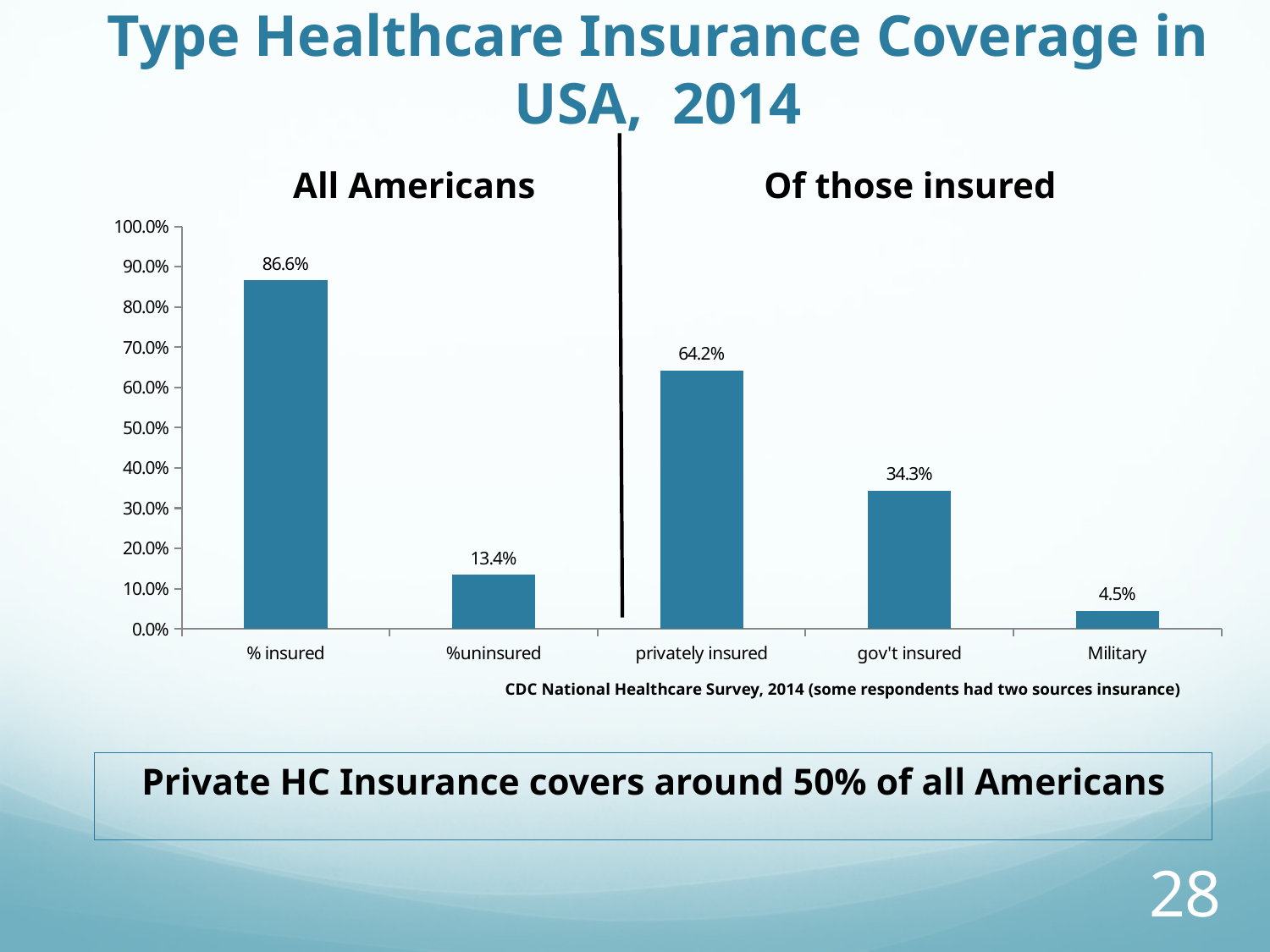
What is the difference between the values for privately insured and gov't insured? 29.9% Which is larger, the value for %uninsured or the value for gov't insured? gov't insured What is the value for % insured? 86.6% What is the value for gov't insured? 34.3% What is the value for Military? 4.5% What kind of chart is shown on the slide? bar chart What is the value for privately insured? 64.2% How many categories are shown on the x axis? 5 Which category has the lowest value? Military What is the value for %uninsured? 13.4% Which category has the highest value? % insured What is the title of the slide's chart? Type Healthcare Insurance Coverage in USA, 2014